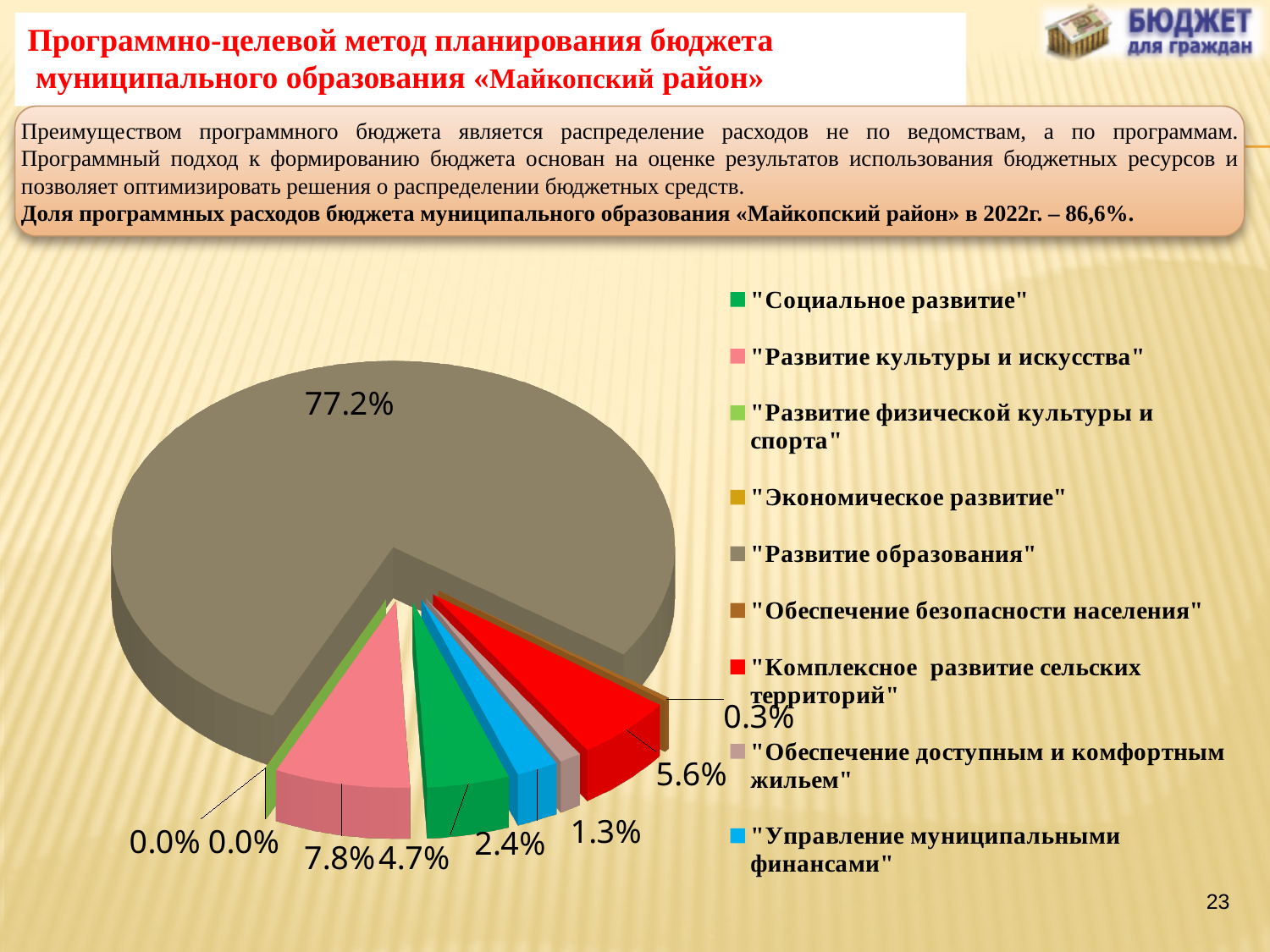
What share of the pie does the largest slice ("Развитие образования") have? 77.2% Which is larger: the share of "Развитие культуры и искусства" or the share of "Комплексное развитие сельских территорий"? "Развитие культуры и искусства" What is the share of the red slice "Комплексное развитие сельских территорий"? 5.6% What is the share of the brown slice "Обеспечение безопасности населения"? 0.3% What is the share of the green slice "Социальное развитие"? 4.7% How many entries does the legend of the pie chart list? 9 What is the difference between the share of "Развитие образования" and the share of "Развитие культуры и искусства"? 69.4% What is the share of the pink slice "Развитие культуры и искусства"? 7.8% Which category has the largest slice of the pie chart? "Развитие образования" What kind of chart is shown on the slide? pie chart What is the share of the blue slice "Управление муниципальными финансами"? 2.4% How many slices in the pie chart are labelled 0.0%? 2